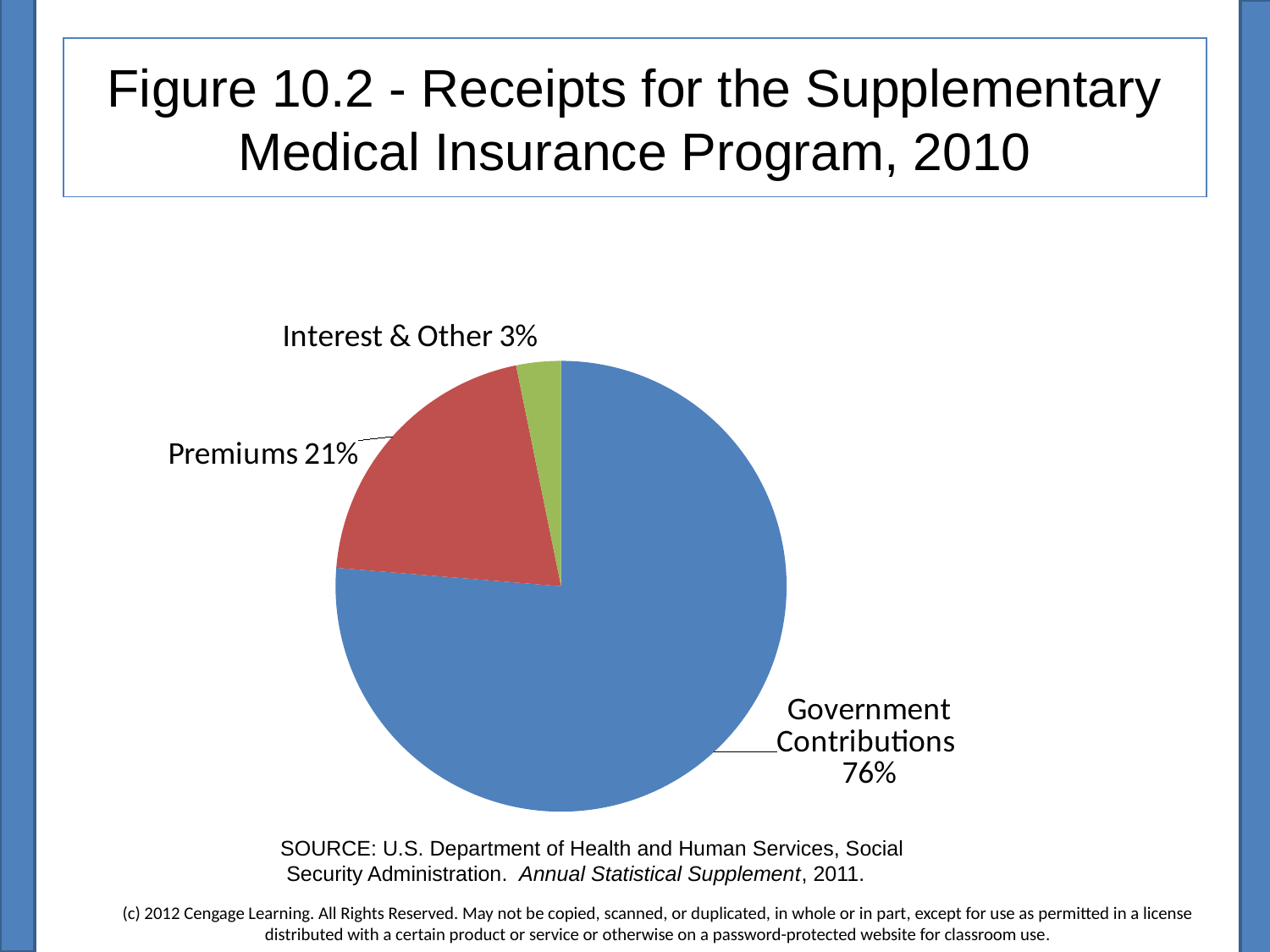
What kind of chart is shown on the slide? pie chart What share of receipts comes from Premiums? 21% How many slices does the pie chart have? 3 What colour is the Government Contributions slice? blue What share of receipts comes from Government Contributions? 76% Which is larger, the share for Premiums or the share for Interest & Other? Premiums Which category has the largest share of receipts? Government Contributions What year does the chart title say the receipts are for? 2010 Which category has the smallest share of receipts? Interest & Other What is the difference in percentage points between Government Contributions and Premiums? 55 What is the difference in percentage points between Premiums and Interest & Other? 18 What share of receipts comes from Interest & Other? 3%